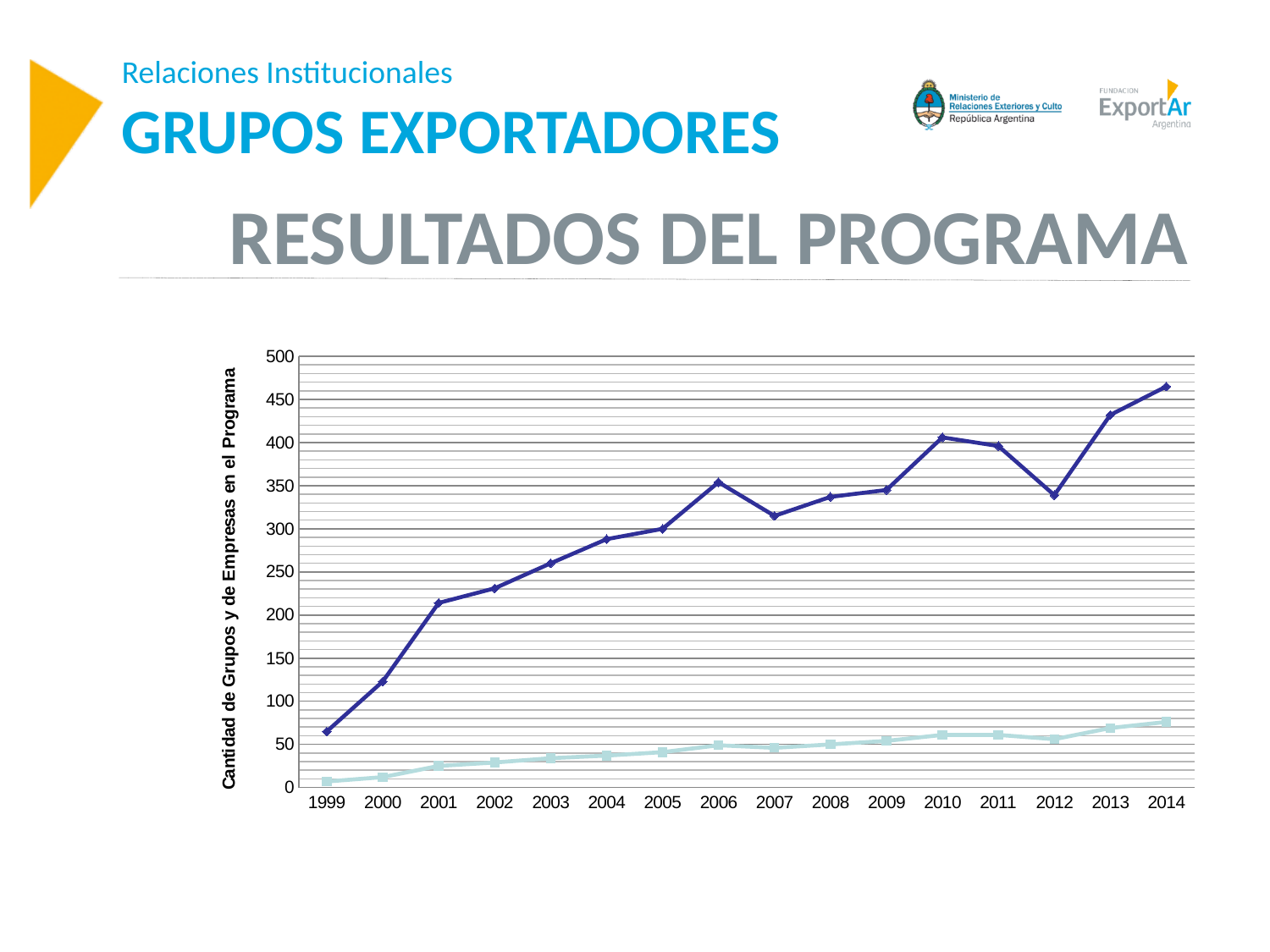
Is the value of the light blue line in 2014 greater or less than 100? less Which year has the larger value on the dark blue line, 2010 or 2012? 2010 Which year has the larger value on the dark blue line, 2006 or 2007? 2006 Is the value of the dark blue line in 2014 greater or less than 450? greater In which year does the dark blue line reach its highest value? 2014 What is the label of the vertical axis of the chart? Cantidad de Grupos y de Empresas en el Programa In which year does the dark blue line have its lowest value? 1999 Is the value of the dark blue line in 2006 greater or less than 300? greater What kind of chart is shown on the slide? line chart How many years are shown along the x axis of the chart? 16 Does the dark blue line rise or fall between 1999 and 2006? rise